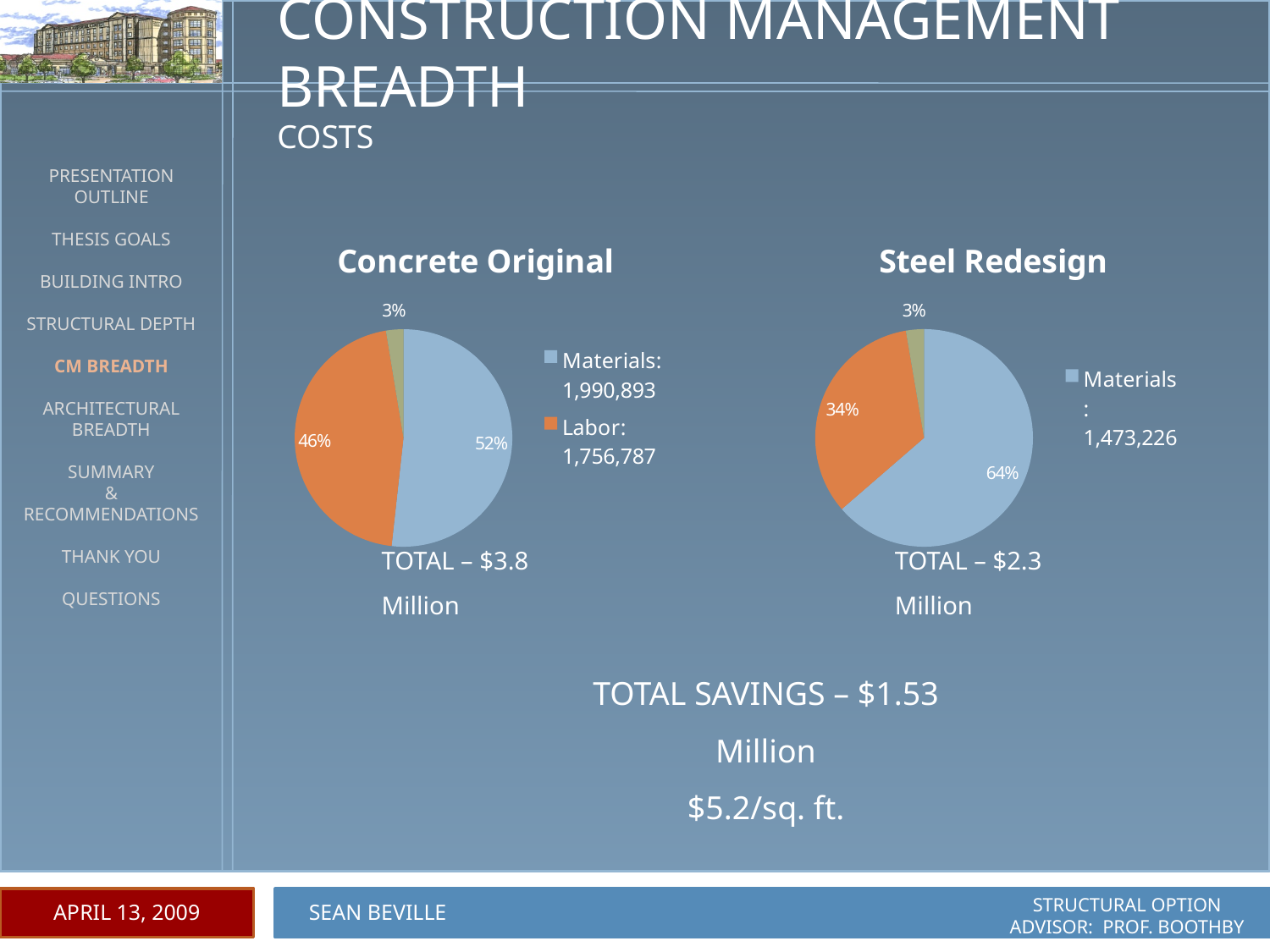
What is the title of the pie chart on the left? Concrete Original In the Steel Redesign chart, what is the value for Materials shown in the legend? 1,473,226 In the Concrete Original chart, what is the difference between the Materials and Labor values? 234,106 In the Concrete Original chart, what is the value for Labor shown in the legend? 1,756,787 In the Concrete Original chart, what share of the pie is Materials? 52% What kind of chart is the Concrete Original chart? pie chart In the Concrete Original chart, which is larger, Materials or Labor? Materials How many slices does the Steel Redesign pie chart have? 3 In the Concrete Original chart, what is the value for Materials shown in the legend? 1,990,893 In the Steel Redesign chart, what share of the pie is Materials? 64% In the Concrete Original chart, what share of the pie is Labor? 46% In the Steel Redesign chart, what is the smallest slice's percentage? 3%